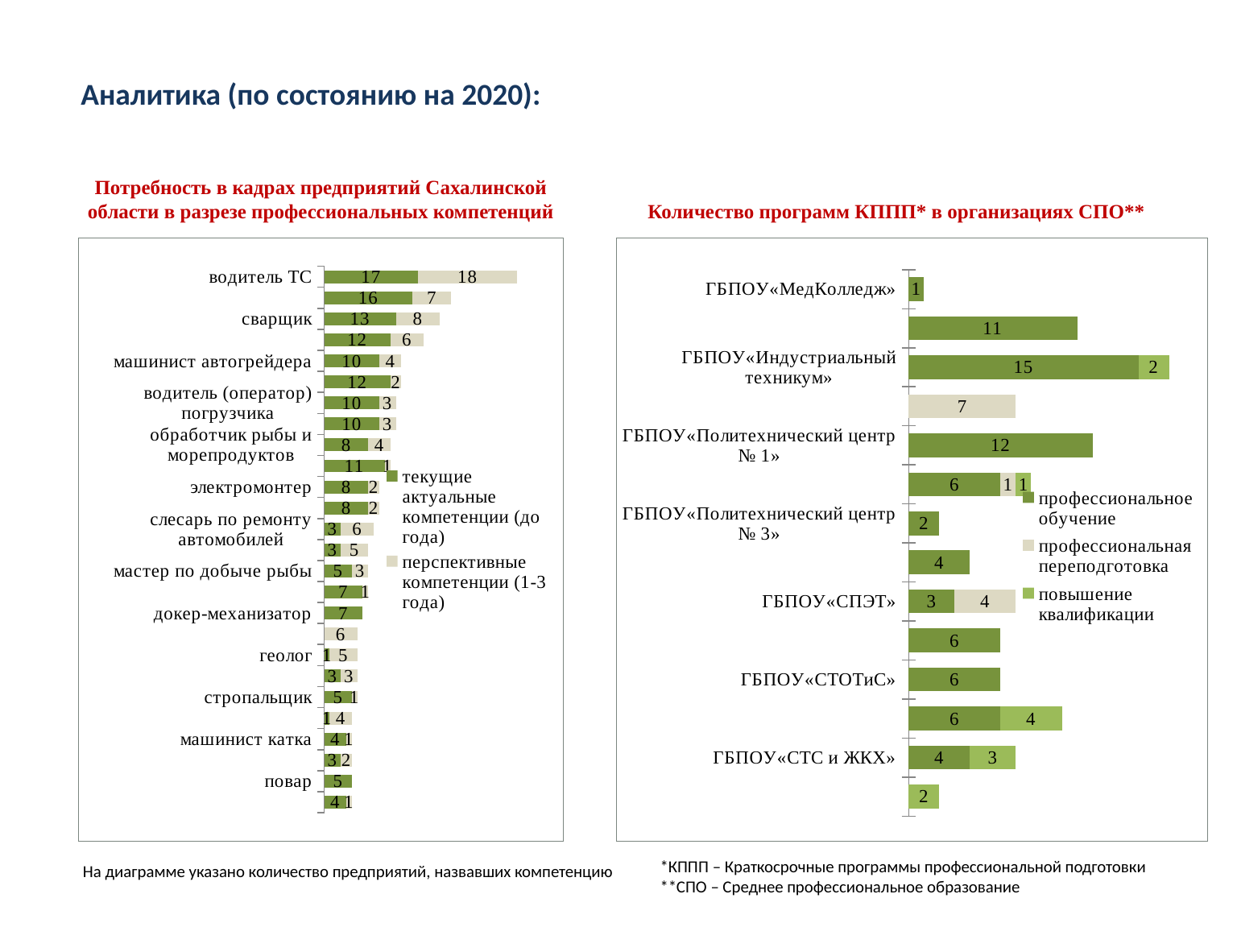
In the left chart 'Потребность в кадрах предприятий Сахалинской области', what is the total of the stacked bar for 'водитель ТС'? 35 In the right chart 'Количество программ КППП в организациях СПО', what is the total of the stacked bar for 'ГБПОУ«СПЭТ»'? 7 In the left chart 'Потребность в кадрах предприятий Сахалинской области', what is the value of 'перспективные компетенции (1-3 года)' for 'сварщик'? 8 What kind of chart is the left chart, 'Потребность в кадрах предприятий Сахалинской области в разрезе профессиональных компетенций'? bar chart In the right chart 'Количество программ КППП в организациях СПО', what is the value of 'профессиональное обучение' for 'ГБПОУ«Индустриальный техникум»'? 15 In the left chart 'Потребность в кадрах предприятий Сахалинской области', how many series does the legend list? 2 In the left chart 'Потребность в кадрах предприятий Сахалинской области', which labeled category has the highest value for 'текущие актуальные компетенции (до года)'? водитель ТС In the right chart 'Количество программ КППП в организациях СПО', how many series does the legend list? 3 In the right chart 'Количество программ КППП в организациях СПО', which has the larger 'профессиональное обучение' value: 'ГБПОУ«Политехнический центр № 1»' or 'ГБПОУ«Политехнический центр № 3»'? ГБПОУ«Политехнический центр № 1» In the right chart 'Количество программ КППП в организациях СПО', what is the value of 'повышение квалификации' for 'ГБПОУ«СТС и ЖКХ»'? 3 In the left chart 'Потребность в кадрах предприятий Сахалинской области', what is the value of 'текущие актуальные компетенции (до года)' for 'водитель ТС'? 17 In the left chart 'Потребность в кадрах предприятий Сахалинской области', what is the difference between the 'текущие актуальные компетенции' and 'перспективные компетенции' values for 'сварщик'? 5